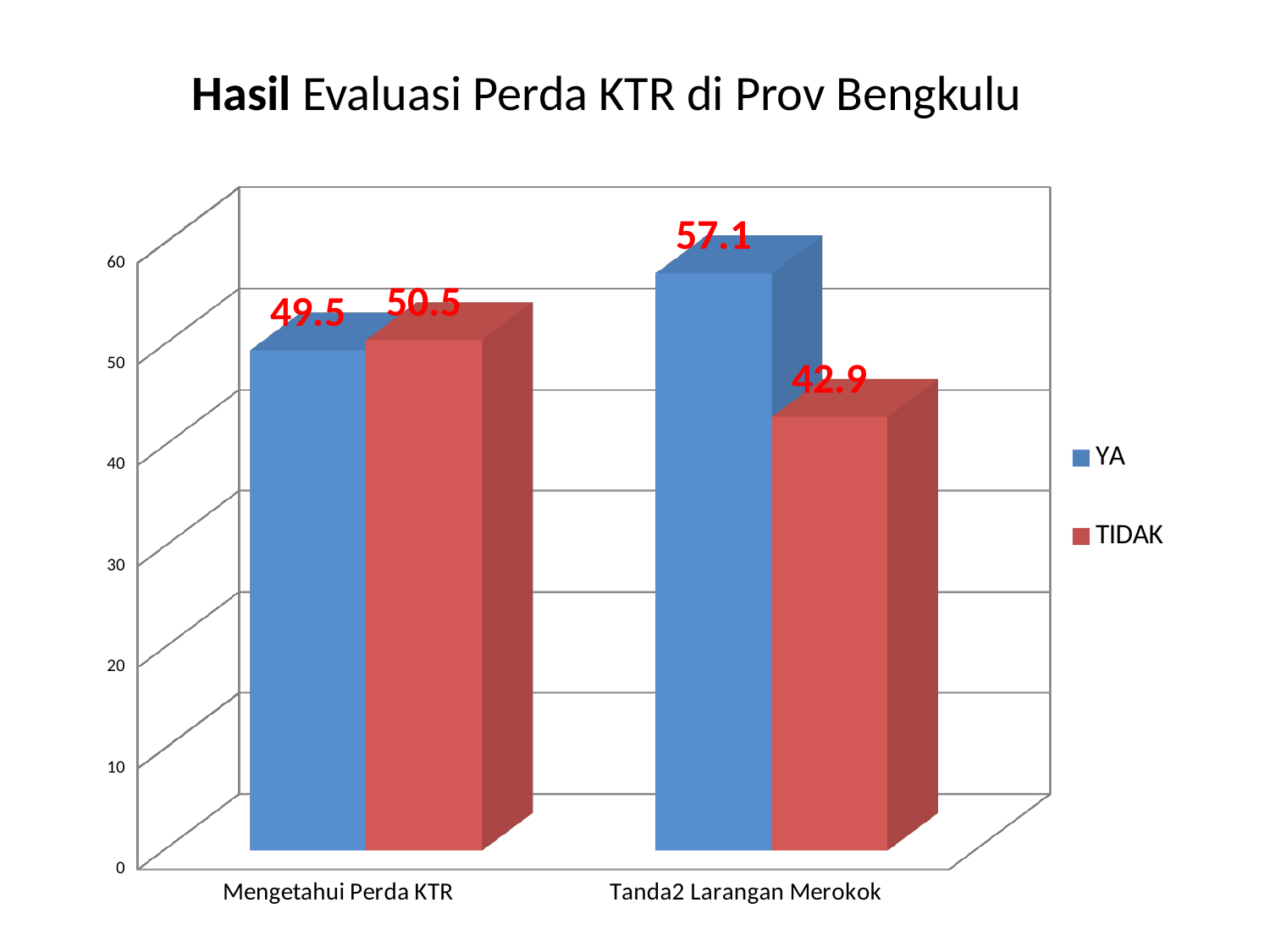
Which category has the highest YA value? Tanda2 Larangan Merokok What is the YA value for Mengetahui Perda KTR? 49.5 What is the TIDAK value for Mengetahui Perda KTR? 50.5 What is the YA value for Tanda2 Larangan Merokok? 57.1 How many categories are shown on the x axis? 2 How many series does the legend list? 2 What is the TIDAK value for Tanda2 Larangan Merokok? 42.9 For Tanda2 Larangan Merokok, which is larger, YA or TIDAK? YA Which category has the lowest TIDAK value? Tanda2 Larangan Merokok What is the difference between the YA values for Tanda2 Larangan Merokok and Mengetahui Perda KTR? 7.6 What kind of chart is shown on the slide? Bar chart What is the difference between the YA and TIDAK values for Tanda2 Larangan Merokok? 14.2